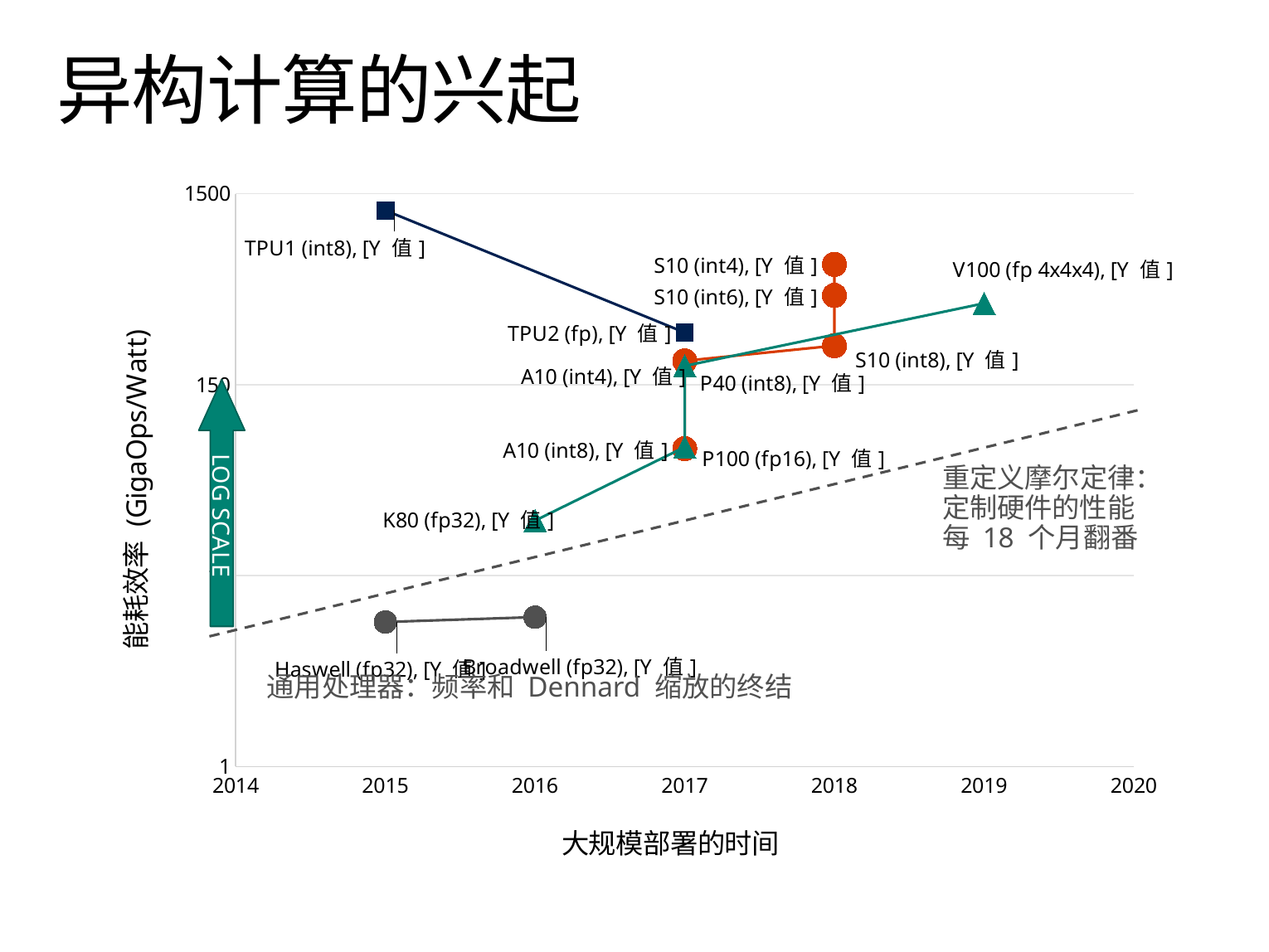
Is the value for Haswell (fp32) greater or less than 150? less What kind of chart is shown on the slide? scatter chart with connected points (line chart with markers) What is the title of the y axis of the chart? 能耗效率 (GigaOps/Watt) Is the value for K80 (fp32) greater or less than 150? less Which has the higher energy efficiency, K80 (fp32) or V100 (fp 4x4x4)? V100 (fp 4x4x4) Which has the higher energy efficiency, TPU1 (int8) or TPU2 (fp)? TPU1 (int8) Does the teal series from K80 (fp32) in 2016 to V100 (fp 4x4x4) in 2019 rise or fall over time? rise Is the value for TPU1 (int8) greater or less than 150? greater Which labeled point has the highest energy efficiency on the chart? TPU1 (int8) Which has the higher energy efficiency, S10 (int4) or S10 (int8)? S10 (int4)